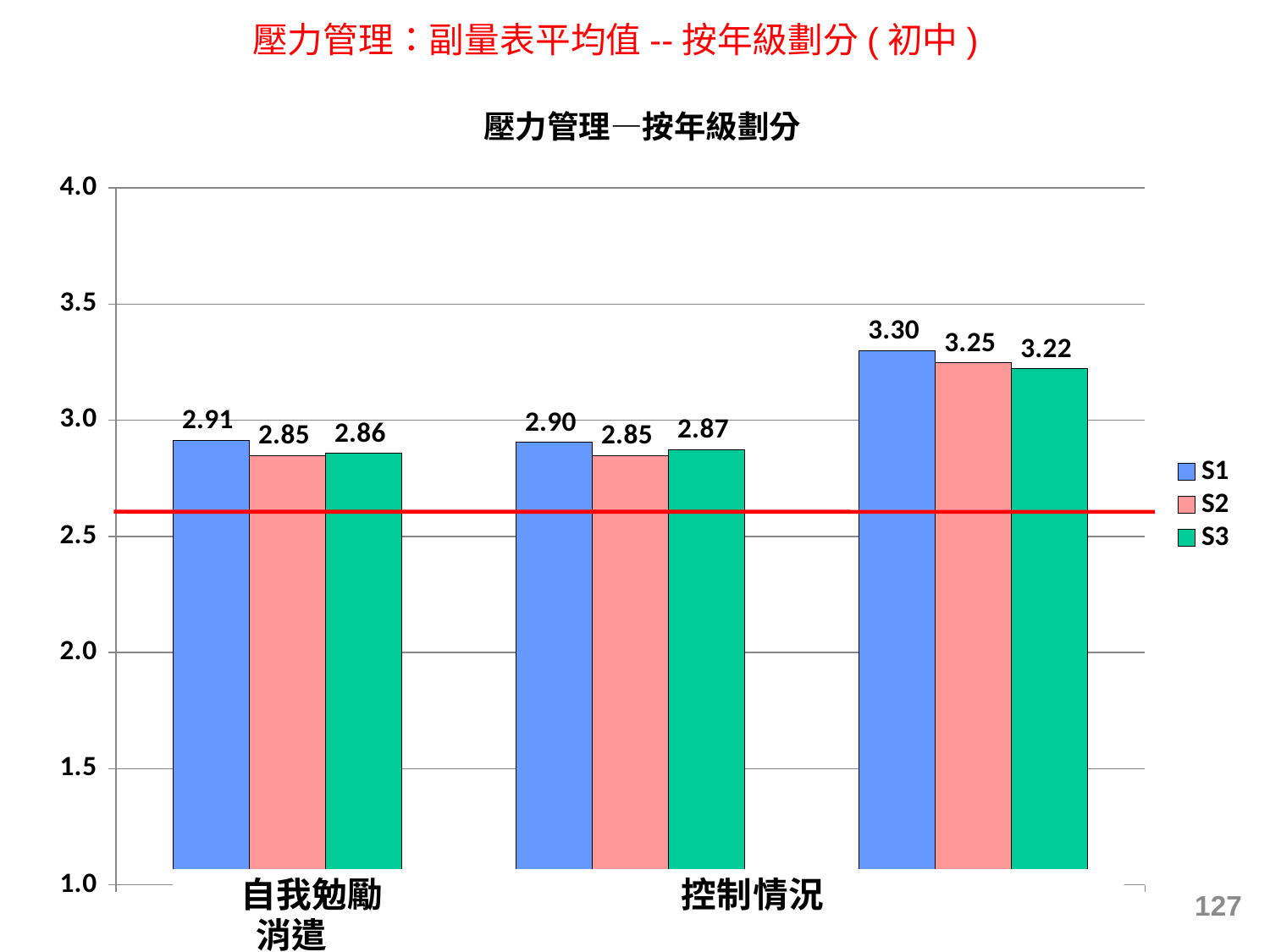
What is the difference between S3 and S2 for 控制情況? 0.02 What is the title of the chart? 壓力管理─按年級劃分 What is the value of S3 for 控制情況? 2.87 What kind of chart is shown on the slide? bar chart How many series does the legend list? 3 What is the value of S1 for 控制情況? 2.90